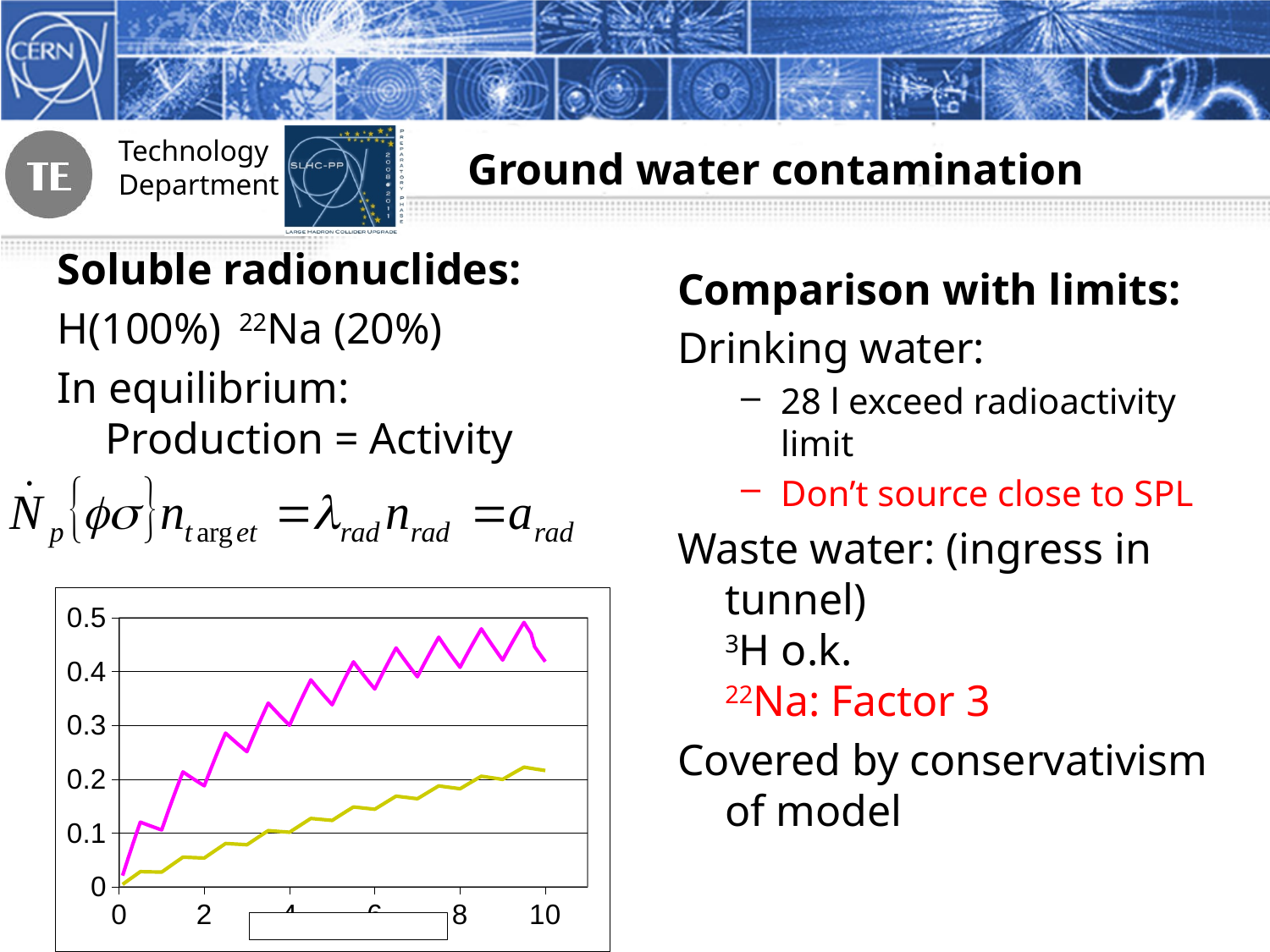
What kind of chart is shown on the slide? line chart Which line is higher at x = 6, the magenta line or the yellow line? magenta What is the highest value labelled on the x axis of the chart? 10 Does the magenta line generally rise or fall as x increases from 0 to 10? rise Does the yellow line generally rise or fall as x increases from 0 to 10? rise Is the value of the magenta line at x = 2 greater or less than 0.1? greater What is the highest value labelled on the y axis of the chart? 0.5 Is the value of the yellow line at x = 10 greater or less than 0.3? less Which line reaches the higher maximum value, the magenta line or the yellow line? magenta Is the value of the magenta line at x = 10 greater or less than 0.3? greater How many lines are plotted on the chart? 2